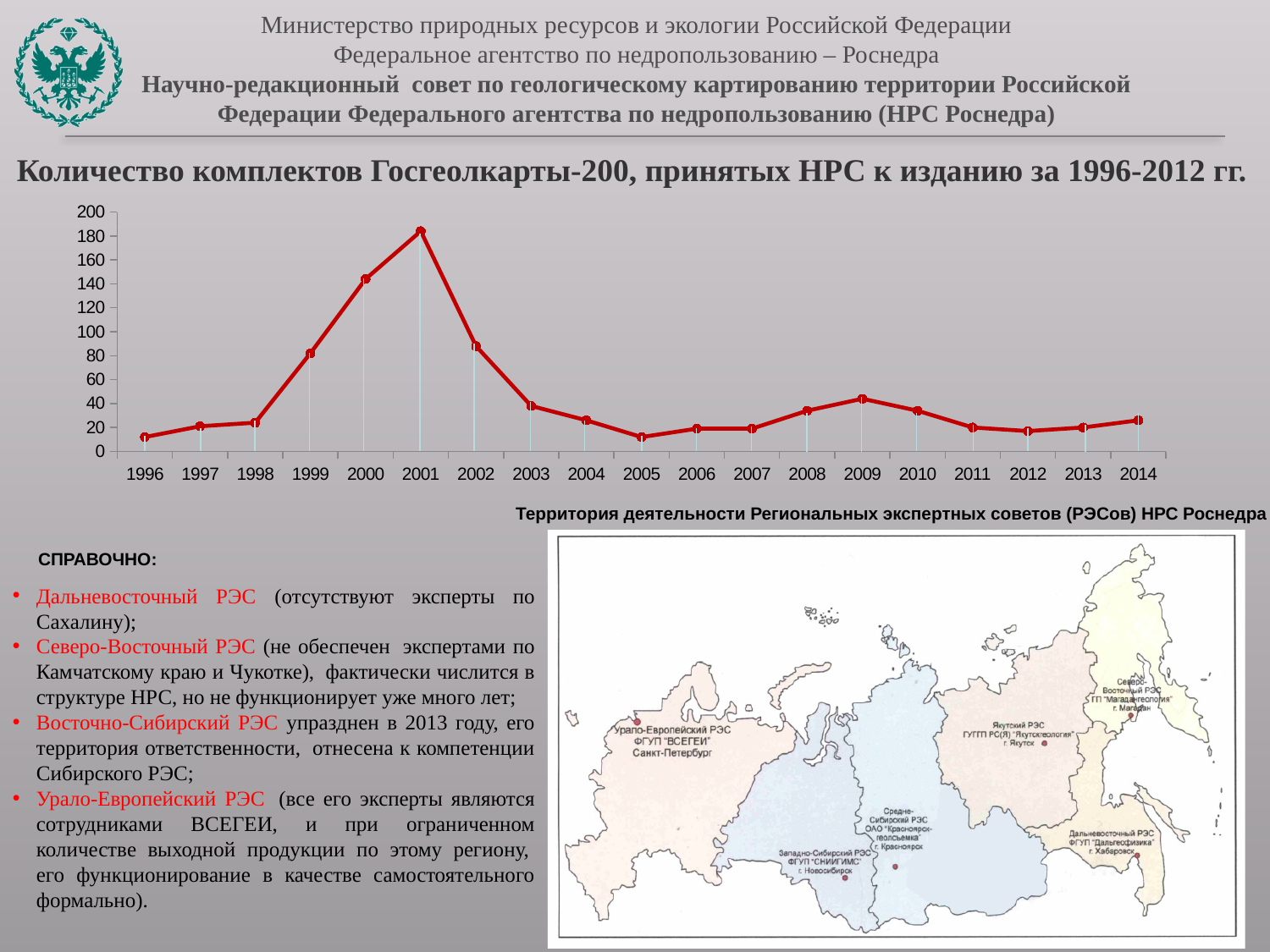
Which year has the larger value, 2005 or 2009? 2009 What kind of chart is shown on the slide? line chart Is the value for 1996 greater or less than 20? less Is the value for 2000 greater or less than 120? greater Is the value for 2001 greater or less than 160? greater Which year has the larger value, 2000 or 2002? 2000 Do the values rise or fall from 1998 to 2001? rise How many years (data points) are plotted on the x axis of the chart? 19 In which year was the number of Gosgeolkarta-200 sets accepted for publication the highest? 2001